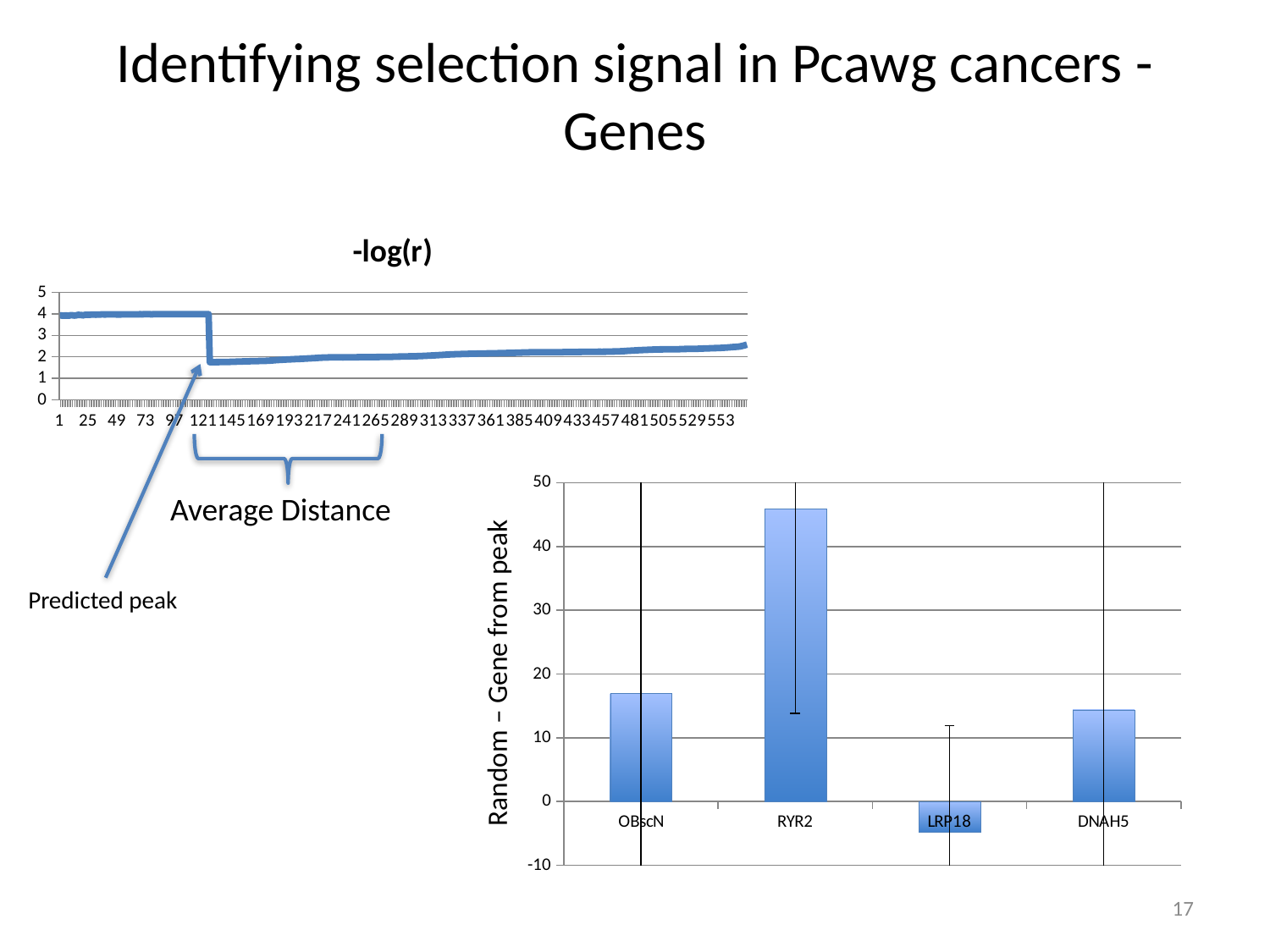
What kind of chart is the chart titled "-log(r)"? line chart In the bottom-right bar chart, which is larger, the value for RYR2 or the value for DNAH5? RYR2 In the bottom-right bar chart, is the value for RYR2 greater or less than 40? greater In the bottom-right bar chart, which category has the highest bar? RYR2 In the bottom-right bar chart, how many categories are shown on the x axis? 4 What is the title of the line chart on the slide? -log(r) In the bottom-right bar chart, is the value for LRP18 greater or less than 0? less In the bottom-right bar chart, which category has the lowest bar? LRP18 What is the y-axis title of the bottom-right bar chart? Random – Gene from peak In the bottom-right bar chart, which is larger, the value for OBscN or the value for DNAH5? OBscN What kind of chart is the bottom-right chart with categories OBscN, RYR2, LRP18 and DNAH5? bar chart In the bottom-right bar chart, is the value for OBscN greater or less than 20? less